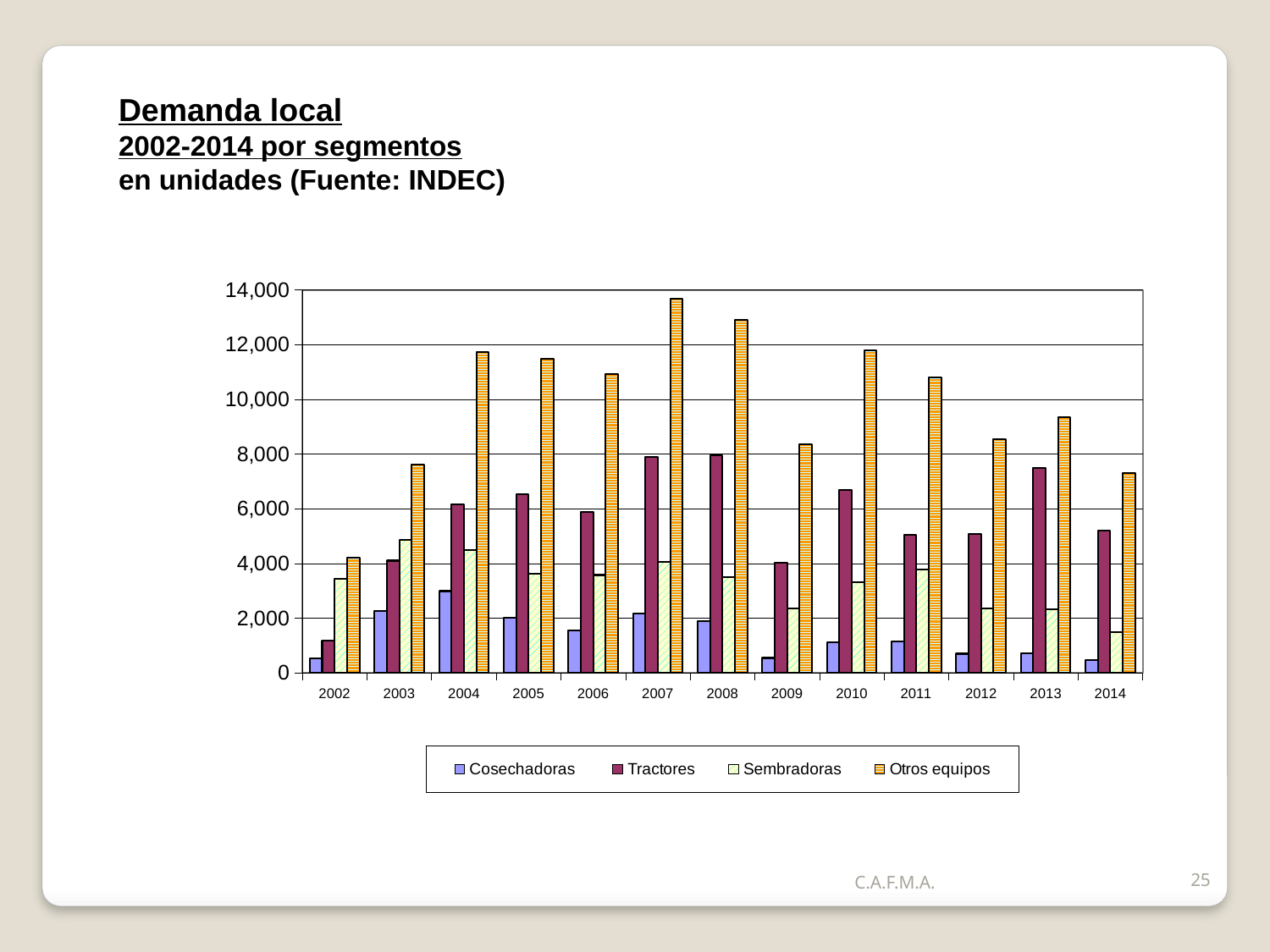
Which is larger, the value for Tractores in 2013 or in 2014? 2013 Which is larger, the value for Sembradoras in 2003 or in 2014? 2003 Is the value for Otros equipos in 2007 greater or less than 12,000? greater In which year is the value for Otros equipos highest? 2007 In which year is the value for Cosechadoras highest? 2004 In which year is the value for Otros equipos lowest? 2002 Is the value for Tractores in 2005 greater or less than 6,000? greater How many years are shown on the x axis? 13 Is the value for Cosechadoras in 2014 greater or less than 2,000? less What kind of chart is shown on the slide? bar chart Do the values for Otros equipos rise or fall from 2010 to 2012? fall How many series does the legend list? 4